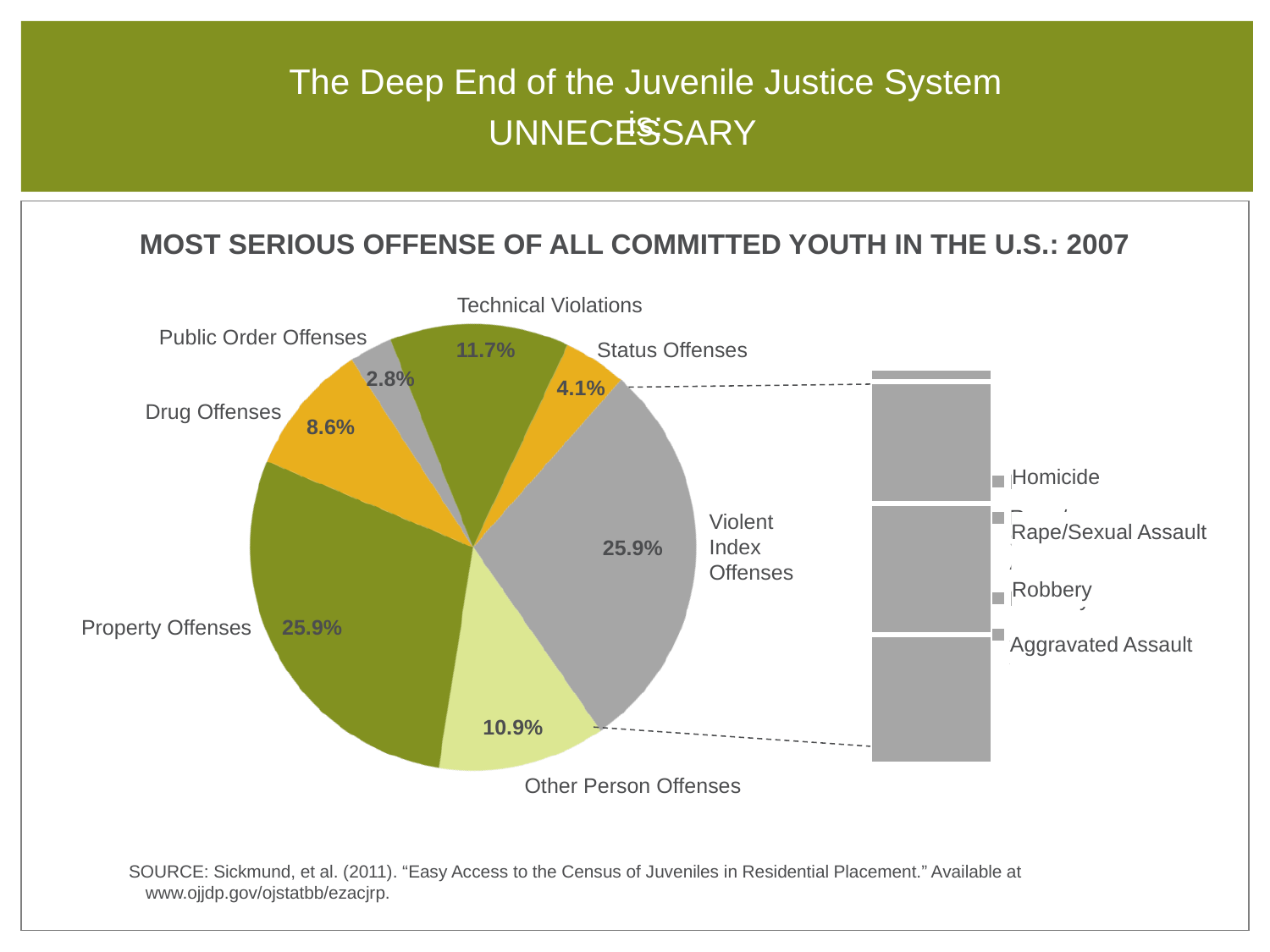
Which offense category has the smallest slice of the pie? Public Order Offenses What percentage is labelled for Other Person Offenses? 10.9% How many offense categories are shown as slices in the pie chart? 7 What is the difference in percentage points between Property Offenses and Drug Offenses? 17.3 What is the value for Violent Index Offenses? 25.9% Which is larger, Technical Violations or Other Person Offenses? Technical Violations What is the value shown for Status Offenses? 4.1% What percentage of committed youth had Technical Violations as their most serious offense? 11.7% What kind of chart is used to show the most serious offense of committed youth? Pie chart What share of the pie is Drug Offenses? 8.6% Which four sub-categories are listed in the breakdown of Violent Index Offenses? Homicide, Rape/Sexual Assault, Robbery, Aggravated Assault Which is larger, Status Offenses or Public Order Offenses? Status Offenses